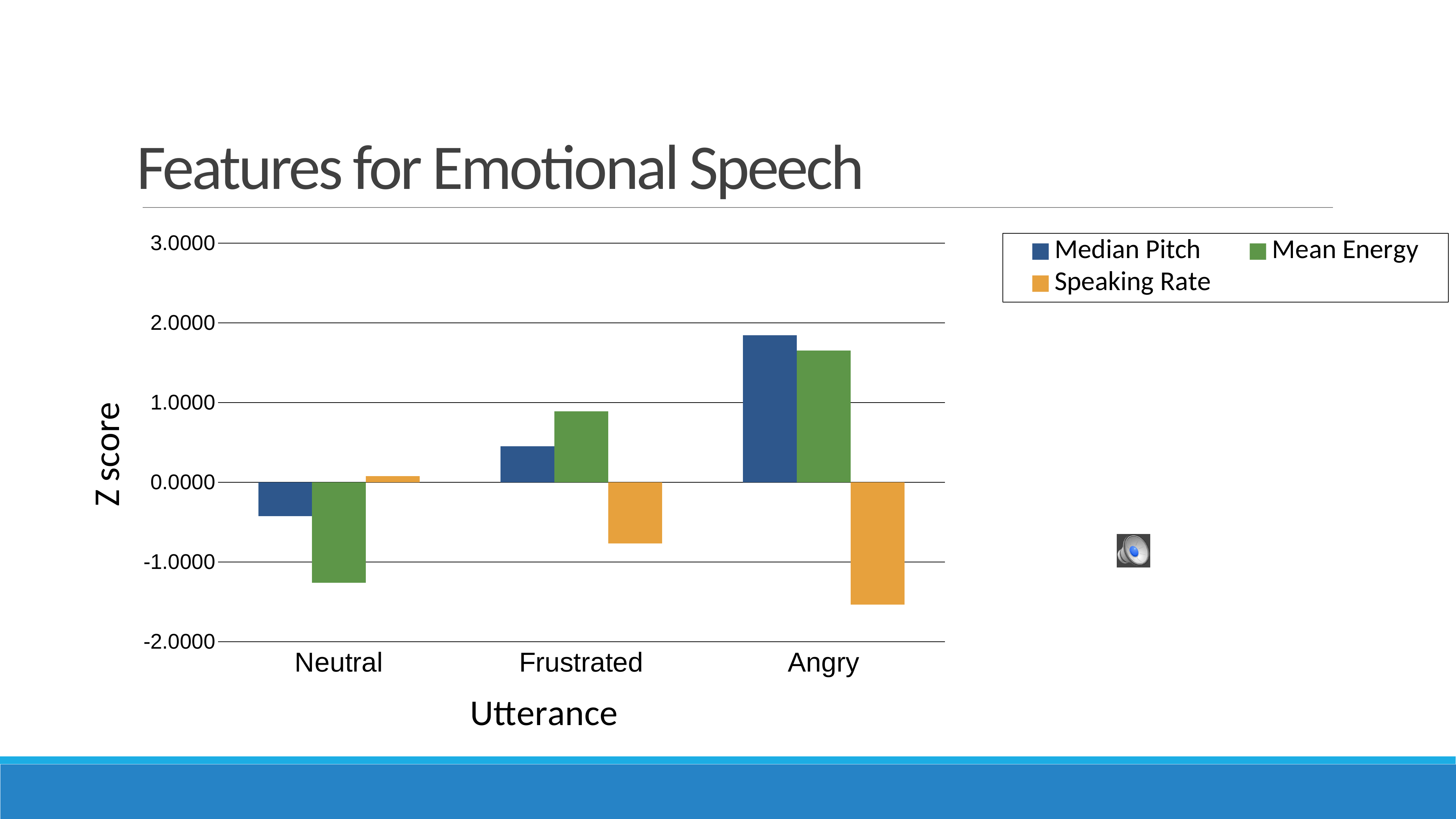
Is the Median Pitch value for Angry greater or less than 2.0000? less What kind of chart is shown on the slide? bar chart Does the Median Pitch z score rise or fall from Neutral to Frustrated to Angry? rise What is the label on the y axis? Z score Is the Mean Energy value for Angry greater or less than 1.0000? greater Which utterance category has the lowest Mean Energy z score? Neutral For Frustrated, which is larger: Median Pitch or Mean Energy? Mean Energy Is the Mean Energy value for Neutral greater or less than -1.0000? less How many utterance categories are shown on the x axis? 3 How many series does the legend list? 3 Which utterance category has the lowest Speaking Rate z score? Angry Which utterance category has the highest Median Pitch z score? Angry